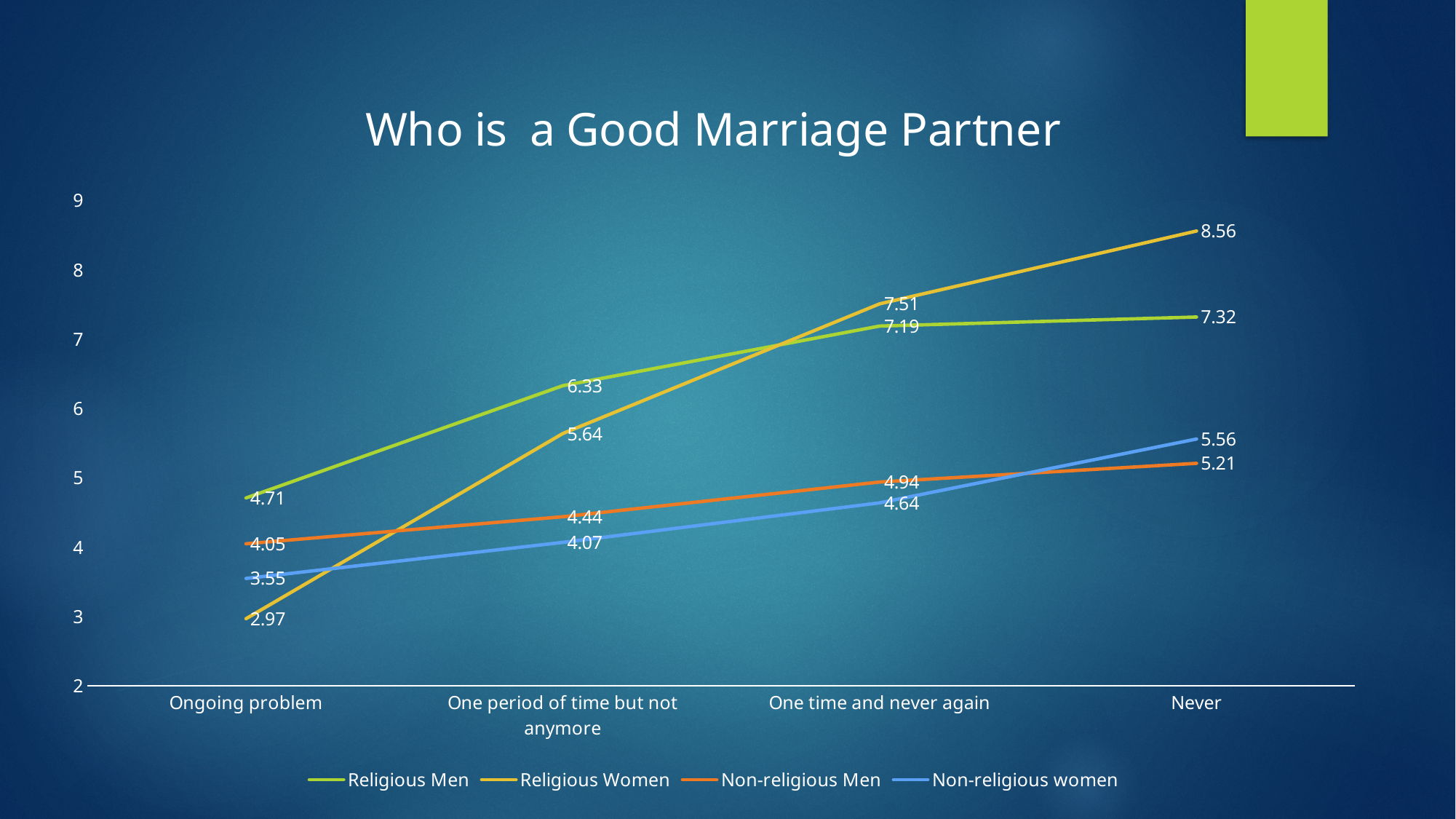
Which series has the highest value at "Never"? Religious Women What is the value for Non-religious women at "One period of time but not anymore"? 4.07 At "One period of time but not anymore", which is larger: Religious Men or Religious Women? Religious Men What is the value for Religious Women at "Never"? 8.56 What type of chart is shown on the slide? Line chart What is the value for Non-religious Men at "One time and never again"? 4.94 What is the value for Religious Men at "Ongoing problem"? 4.71 Do the values for Religious Women rise or fall from "Ongoing problem" to "Never"? Rise How many categories are shown on the x axis? 4 What is the difference between Religious Women and Religious Men at "Never"? 1.24 How many series does the legend list? 4 Which series has the lowest value at "Ongoing problem"? Religious Women